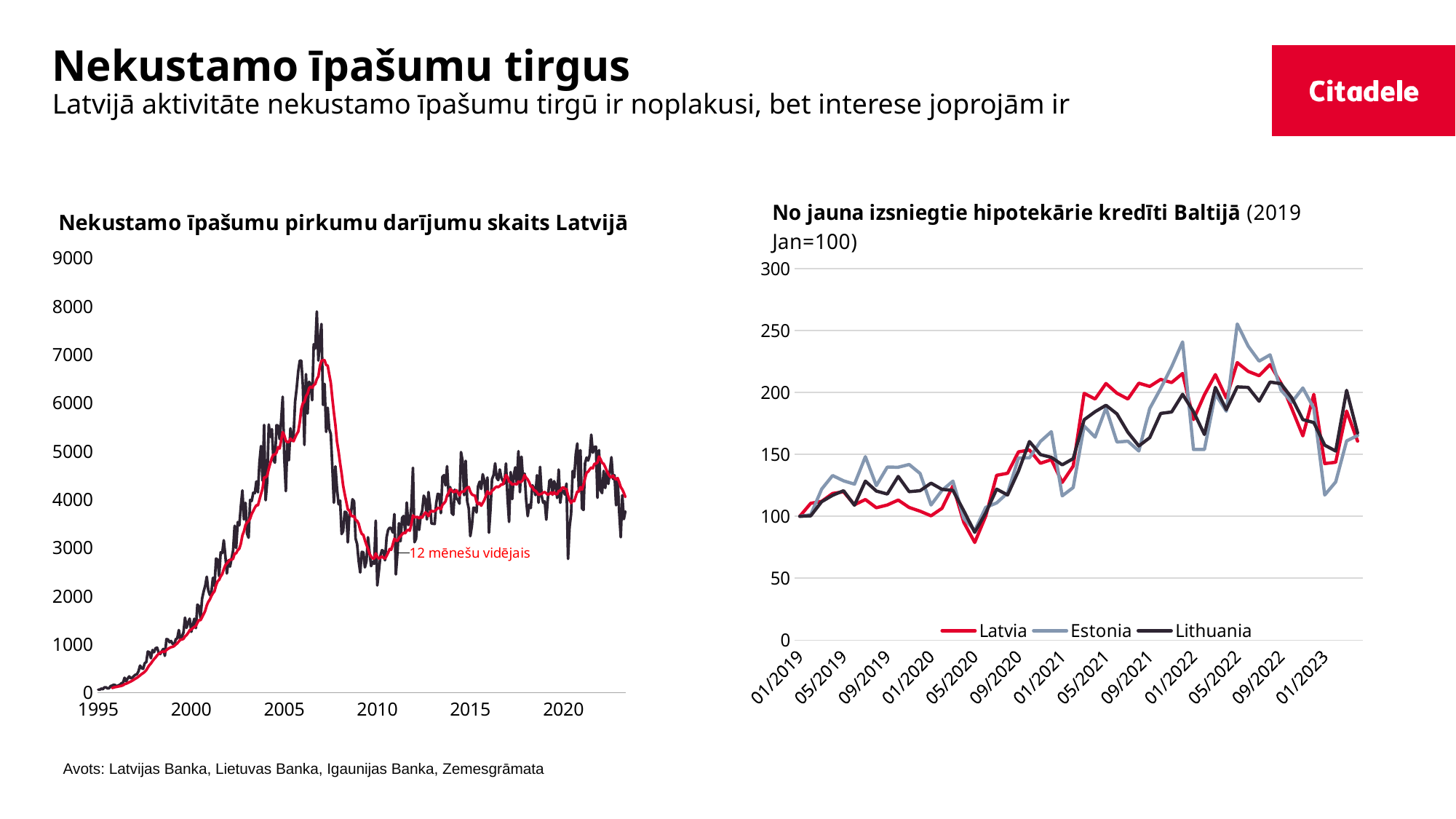
In the right chart, is the lowest value of the Latvia line around 05/2020 greater or less than 100? less In the right chart, is the highest value of the Estonia line greater or less than 200? greater In the right chart, which series is higher at 01/2022, Estonia or Latvia? Latvia In the left chart, do the values rise or fall between 1995 and 2007? Rise In the right chart, what is the index value of all three series at 01/2019? 100 How many series does the legend of the right chart list? 3 In the left chart, is the value at the start of 1995 greater or less than 1000? less Which countries are listed in the legend of the right chart? Latvia, Estonia, Lithuania What kind of chart is the right chart, 'No jauna izsniegtie hipotekārie kredīti Baltijā'? Line chart What kind of chart is the left chart, 'Nekustamo īpašumu pirkumu darījumu skaits Latvijā'? Line chart What does the red line in the left chart represent, according to its label? 12 mēnešu vidējais